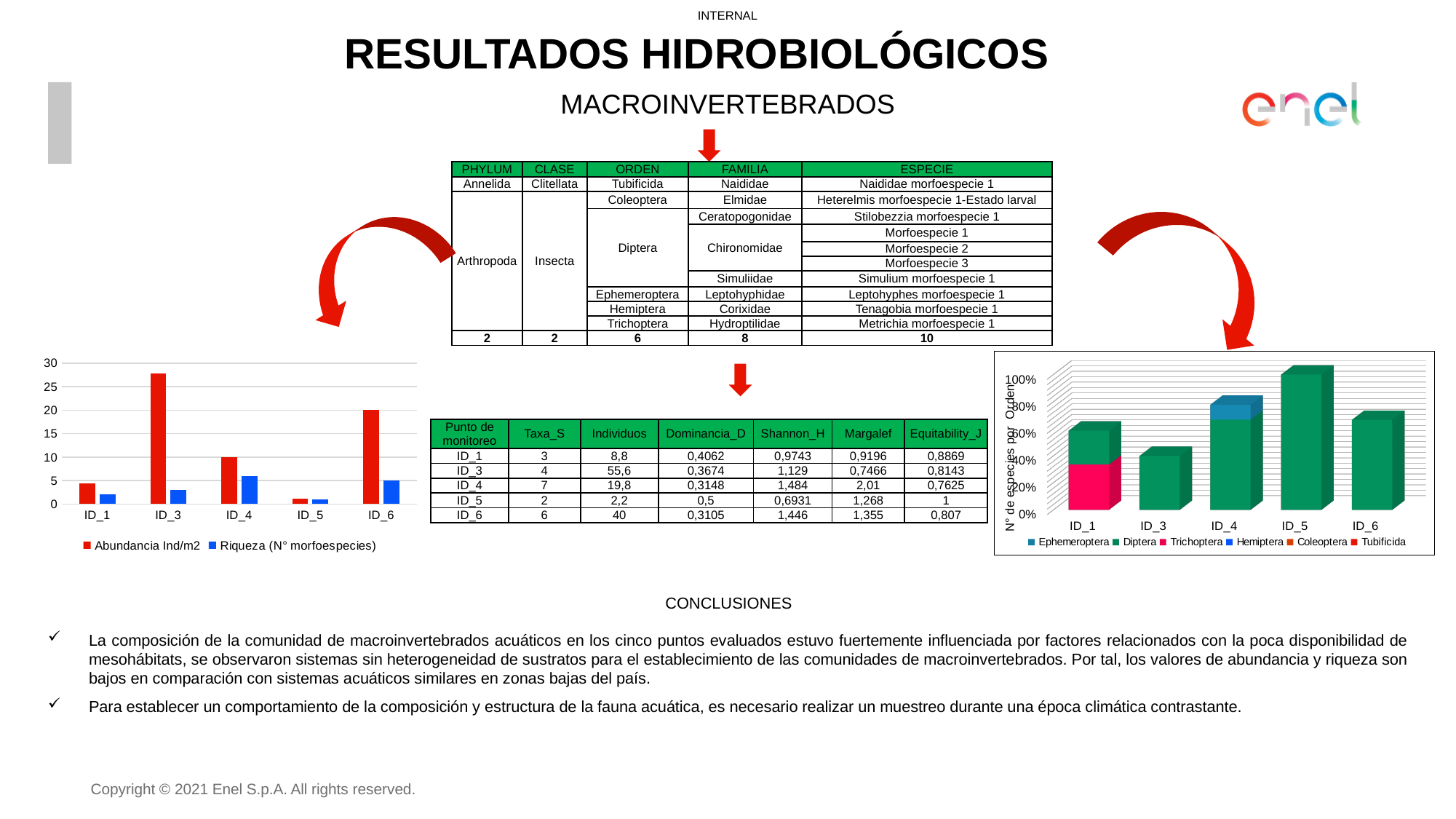
In the left chart, which monitoring point has the highest Riqueza (N° morfoespecies)? ID_4 What kind of chart is the chart on the left of the slide (Abundancia / Riqueza)? bar chart In the left chart, is the Abundancia Ind/m2 value for ID_3 greater or less than 25? greater In the left chart (Abundancia / Riqueza), how many series does the legend list? 2 In the left chart, which has the larger Abundancia Ind/m2, ID_4 or ID_6? ID_6 In the left chart (Abundancia / Riqueza), how many monitoring points are shown on the x axis? 5 In the right chart (N° de especies por Orden), how many monitoring points are shown on the x axis? 5 In the left chart, is the Abundancia Ind/m2 value for ID_6 greater or less than 15? greater In the left chart, which monitoring point has the highest Abundancia Ind/m2? ID_3 In the left chart, which monitoring point has the lowest Abundancia Ind/m2? ID_5 In the right chart (N° de especies por Orden), which series is shown in pink/magenta in the legend? Trichoptera In the right chart (N° de especies por Orden), how many series does the legend list? 6